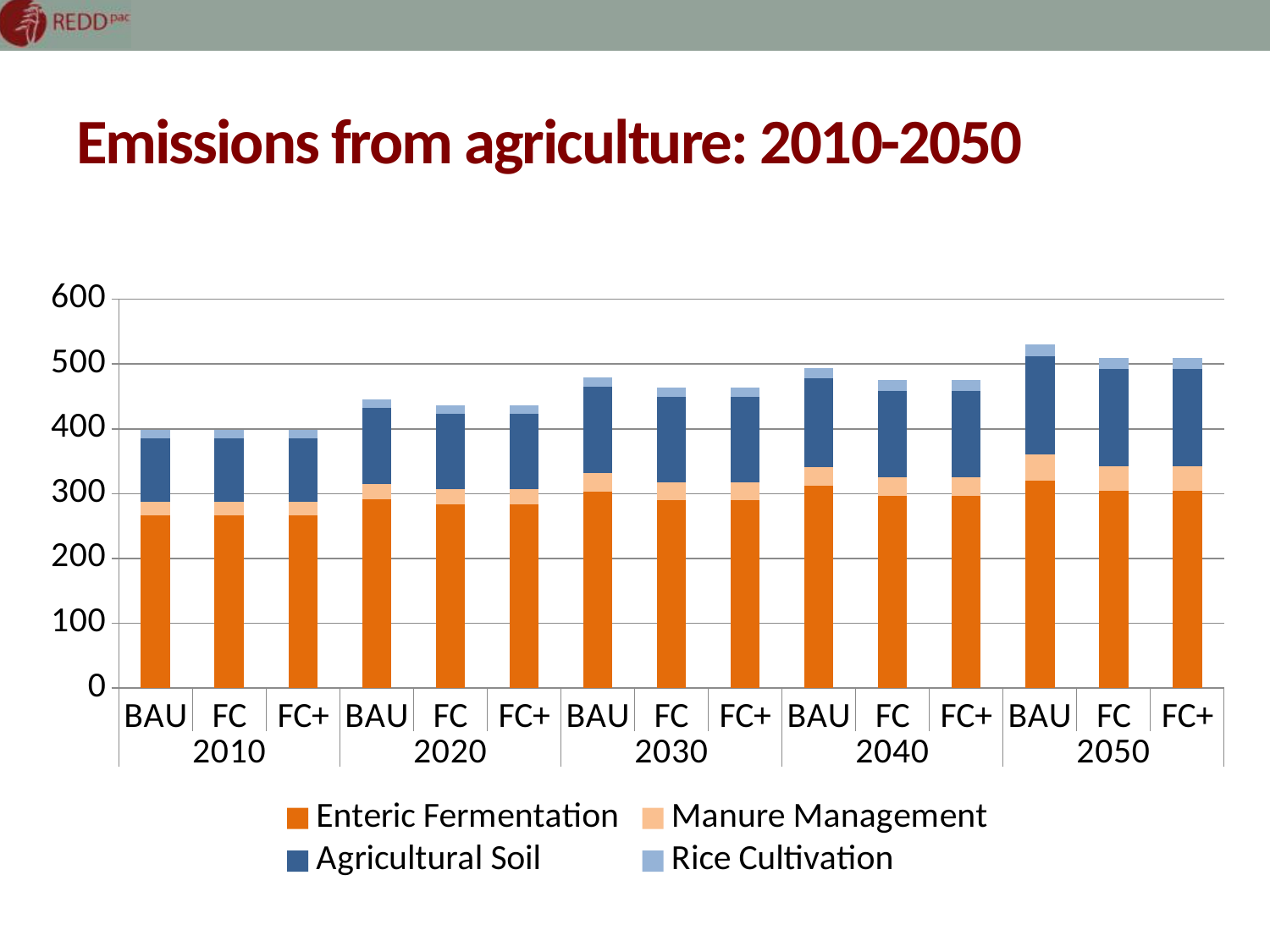
Is the Enteric Fermentation value for BAU in 2050 greater or less than 300? greater Is the total for BAU in 2020 greater or less than 500? less Do the BAU totals rise or fall from 2010 to 2050? rise Is the total for BAU in 2050 greater or less than 500? greater Which is larger, the total for BAU in 2050 or the total for BAU in 2010? BAU in 2050 Which series is shown in orange at the bottom of each bar? Enteric Fermentation What kind of chart is shown on the slide? Stacked bar chart How many series does the legend list? 4 What is the title of the slide's chart? Emissions from agriculture: 2010-2050 Which bar has the highest total emissions? BAU 2050 How many bars are plotted in the chart? 15